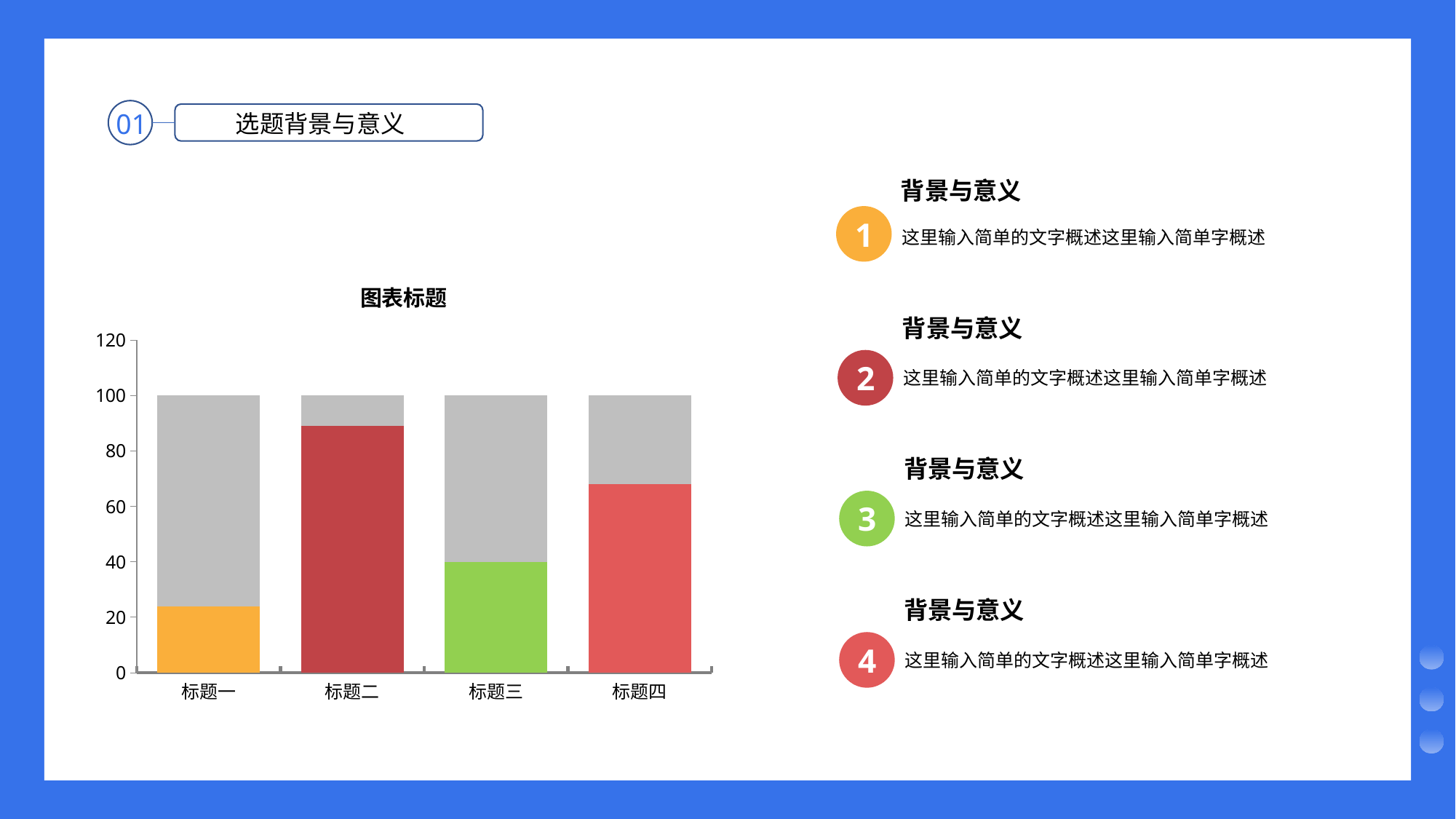
Which category has the tallest coloured (bottom) segment? 标题二 Is the coloured segment for 标题二 greater or less than 80? greater What kind of chart is shown on the slide? bar chart Which category has the shortest coloured (bottom) segment? 标题一 What is the title of the chart? 图表标题 Which is larger, the coloured segment for 标题二 or for 标题三? 标题二 Is the coloured segment for 标题四 greater or less than 60? greater What colour is the bottom segment of the bar for 标题三? green How many categories are shown on the x axis of the chart? 4 Is the coloured segment for 标题一 greater or less than 40? less What is the total height of the stacked bar for 标题一? 100